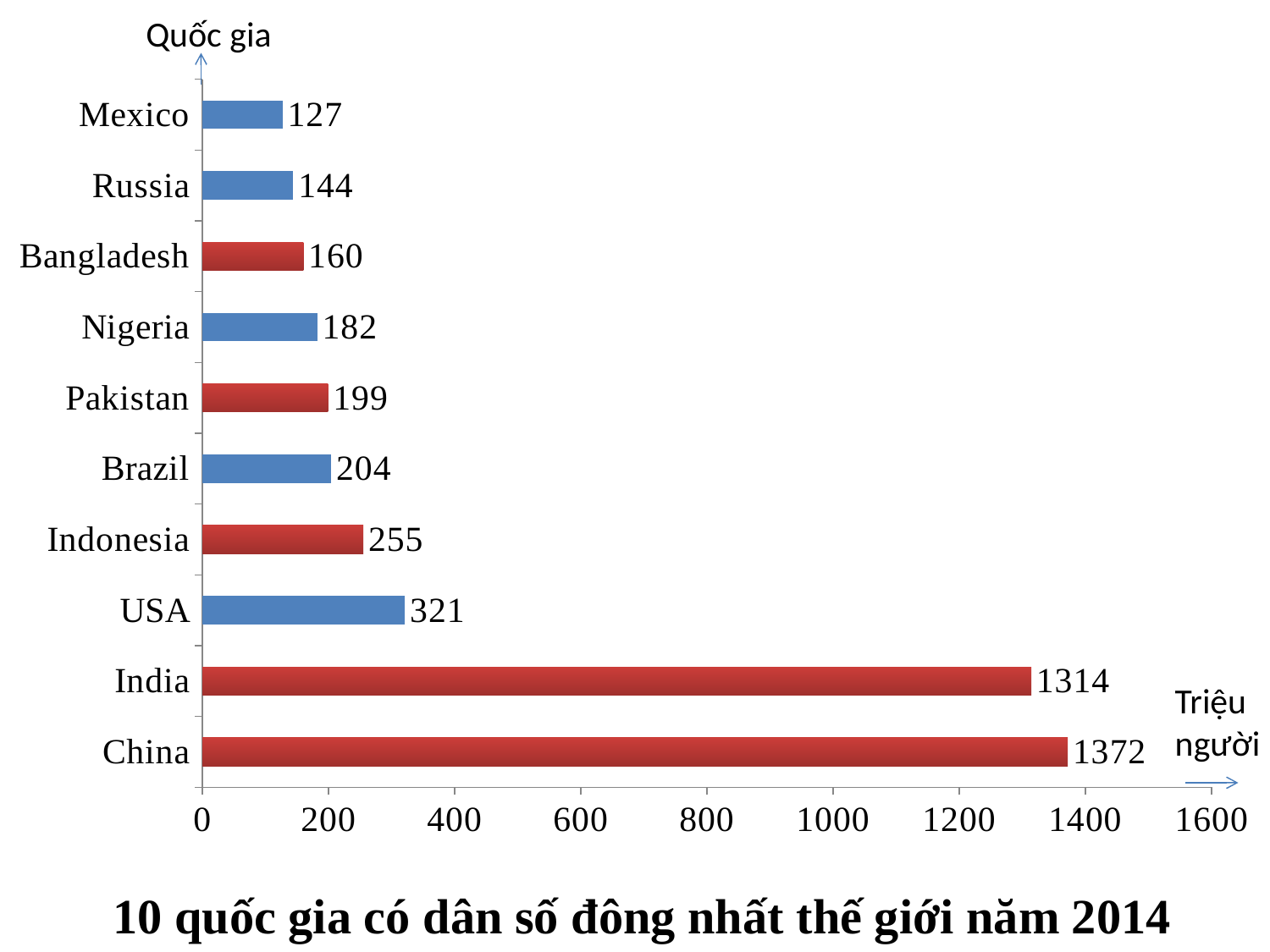
What is the difference between the values for USA and Indonesia? 66 What is the value for China? 1372 What kind of chart is this? bar chart How many countries are shown in the chart? 10 Which country has the lowest value? Mexico Is the value for USA greater or less than 400? less Which country has the highest value? China What is the value for Nigeria? 182 Which is larger, the value for Brazil or the value for Pakistan? Brazil What is the title of the chart? 10 quốc gia có dân số đông nhất thế giới năm 2014 What is the difference between the values for China and India? 58 What is the value for Indonesia? 255